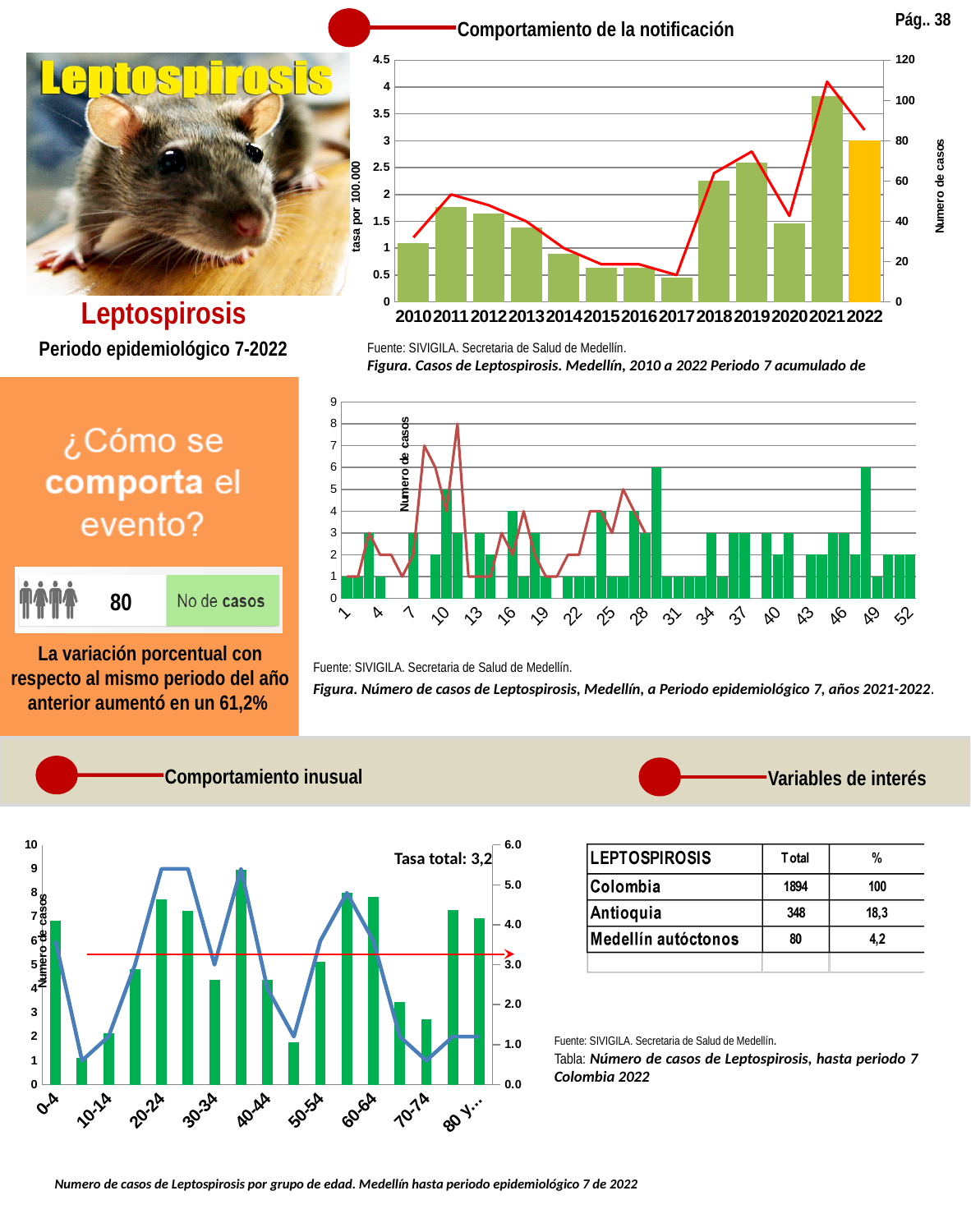
In the top-right chart 'Casos de Leptospirosis. Medellín, 2010 a 2022', which year has the shortest bar? 2017 In the bottom-left chart of cases by age group, which bar is taller, 20-24 or 10-14? 20-24 In the top-right chart 'Casos de Leptospirosis. Medellín, 2010 a 2022', which bar is coloured differently (orange) from the others? 2022 In the middle chart 'Número de casos de Leptospirosis, Medellín, a Periodo epidemiológico 7, años 2021-2022', what kind of chart is it? bar chart with a line In the top-right chart 'Casos de Leptospirosis. Medellín, 2010 a 2022', what is the label of the left vertical axis? tasa por 100.000 In the top-right chart 'Casos de Leptospirosis. Medellín, 2010 a 2022', is the bar for 2017 greater or less than 1 on the left axis? less In the bottom-left chart of cases by age group, is the bar for 70-74 greater or less than 3 on the left axis? less In the middle chart 'Número de casos de Leptospirosis, Medellín, a Periodo epidemiológico 7, años 2021-2022', what is the highest value shown on the vertical axis? 9 In the top-right chart 'Casos de Leptospirosis. Medellín, 2010 a 2022', which year has the tallest bar? 2021 In the bottom-left chart of cases by age group, is the bar for 0-4 greater or less than 5 on the left axis? greater In the top-right chart 'Casos de Leptospirosis. Medellín, 2010 a 2022', how many years are shown on the x axis? 13